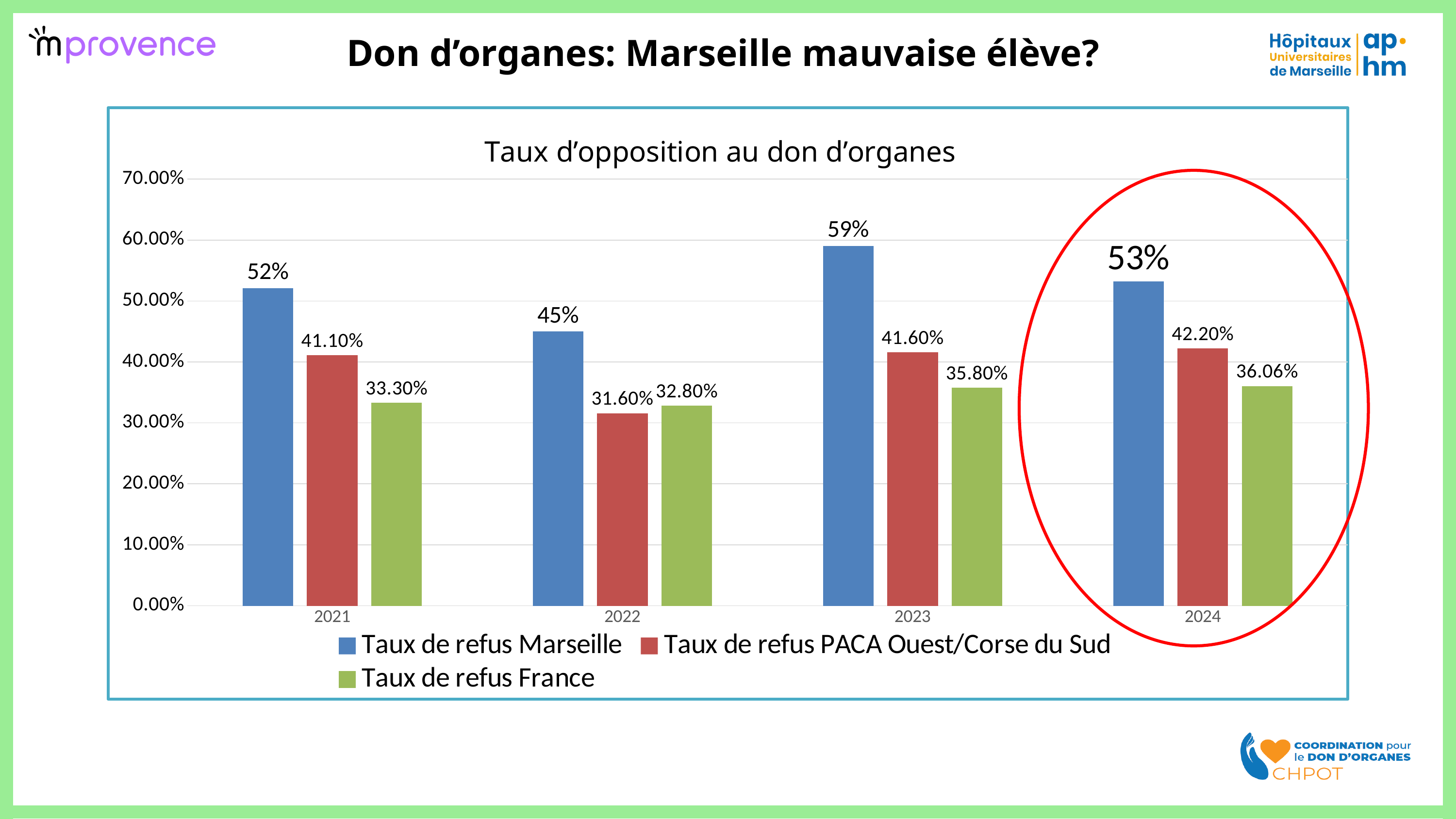
In which year is Taux de refus Marseille highest? 2023 What kind of chart is shown? Bar chart In which year is Taux de refus France lowest? 2022 What is the value for Taux de refus France in 2024? 36.06% What is the value for Taux de refus PACA Ouest/Corse du Sud in 2022? 31.60% How many years are shown on the x axis? 4 Is the value for Taux de refus Marseille in 2022 greater or less than 40.00%? greater What is the title of the chart? Taux d'opposition au don d'organes What is the value for Taux de refus Marseille in 2023? 59% Which is larger in 2024: Taux de refus Marseille or Taux de refus PACA Ouest/Corse du Sud? Taux de refus Marseille How many series does the legend list? 3